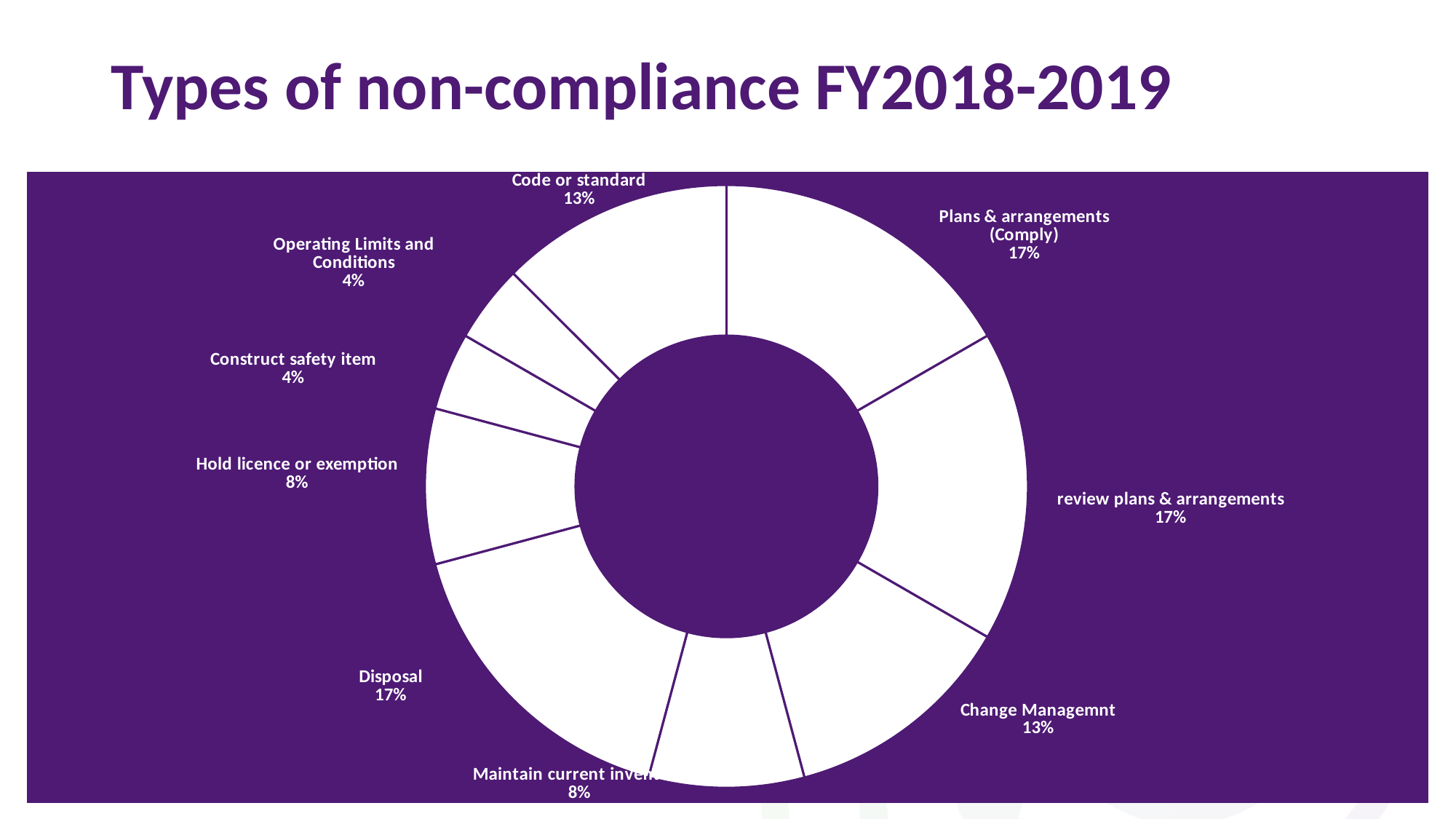
What percentage is shown for Code or standard? 13% Which has a larger share, Disposal or Hold licence or exemption? Disposal What is the difference in percentage points between review plans & arrangements and Change Managemnt? 4 percentage points How many categories are shown in the chart? 9 What percentage of non-compliance is attributed to Disposal? 17% What percentage is shown for Hold licence or exemption? 8% What is the title of the slide? Types of non-compliance FY2018-2019 What is the share for Change Managemnt? 13% What is the share for Plans & arrangements (Comply)? 17% What is the value for Operating Limits and Conditions? 4% What percentage is attributed to Construct safety item? 4% What type of chart is shown on the slide? Doughnut chart